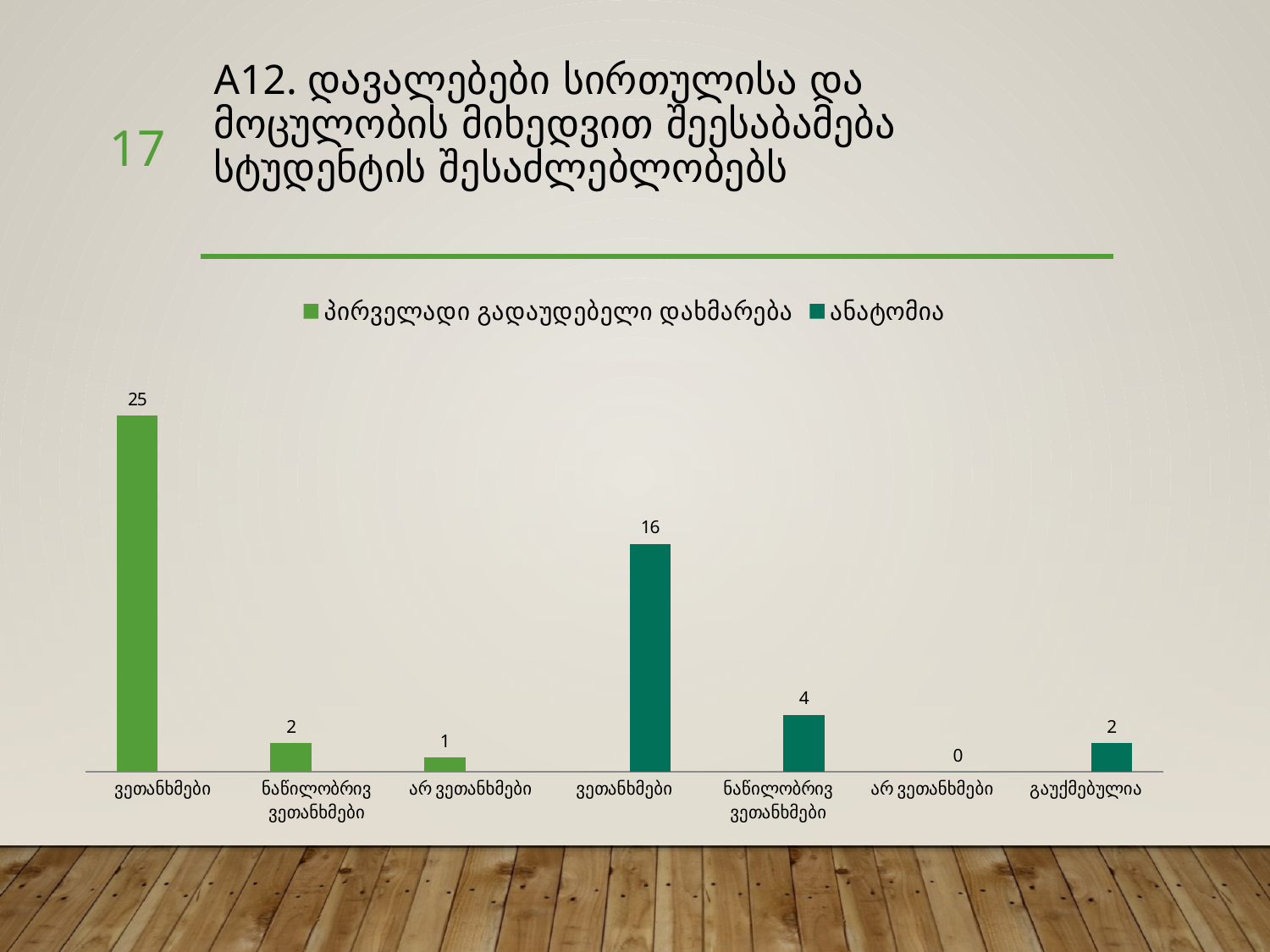
What is the value of the 'ვეთანხმები' bar for the series 'პირველადი გადაუდებელი დახმარება'? 25 What is the value of the 'გაუქმებულია' bar? 2 How many bars (category labels) are shown along the x axis? 7 How many series does the legend list? 2 What is the value of the 'ნაწილობრივ ვეთანხმები' bar for the series 'ანატომია'? 4 Which bar has the highest value in the chart? ვეთანხმები (პირველადი გადაუდებელი დახმარება) What is the value of the 'ვეთანხმები' bar for the series 'ანატომია'? 16 What is the value of the 'არ ვეთანხმები' bar for the series 'ანატომია'? 0 What type of chart is shown on the slide? bar chart Which is larger: the 'ნაწილობრივ ვეთანხმები' value for 'პირველადი გადაუდებელი დახმარება' or for 'ანატომია'? ანატომია What is the difference between the 'ვეთანხმები' value for 'პირველადი გადაუდებელი დახმარება' and the 'ვეთანხმები' value for 'ანატომია'? 9 What is the second legend entry in the chart? ანატომია